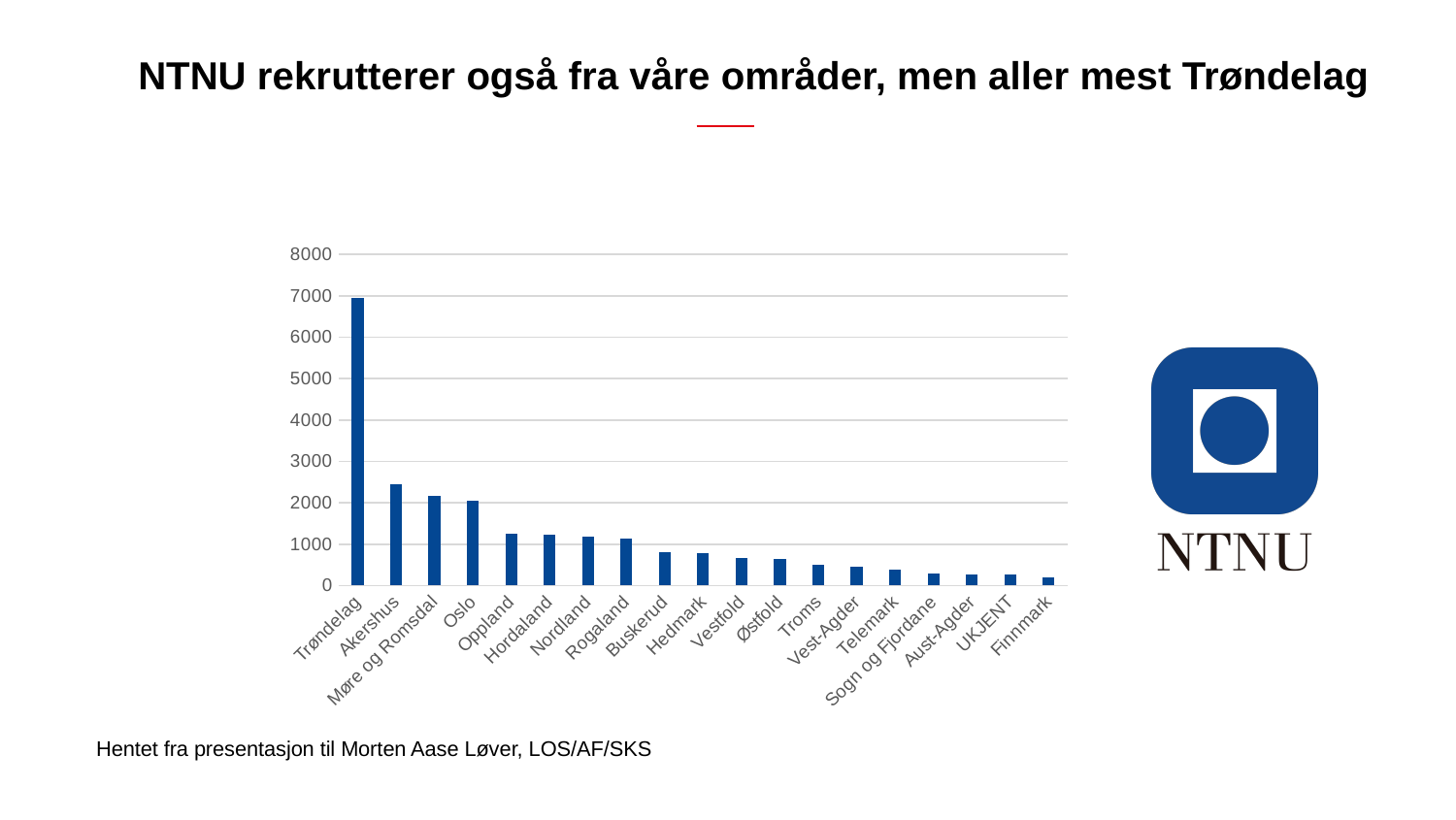
Do the values rise or fall moving from left to right along the x axis? fall Is the value for Trøndelag greater or less than 6000? greater Which region has the lowest value in the chart? Finnmark Is the value for Buskerud greater or less than 1000? less Which region has the highest value in the chart? Trøndelag Is the value for Finnmark greater or less than 1000? less Which has the larger value, Akershus or Oslo? Akershus How many categories are shown along the x axis of the chart? 19 What kind of chart is shown on the slide? bar chart What is the title of the slide containing the chart? NTNU rekrutterer også fra våre områder, men aller mest Trøndelag